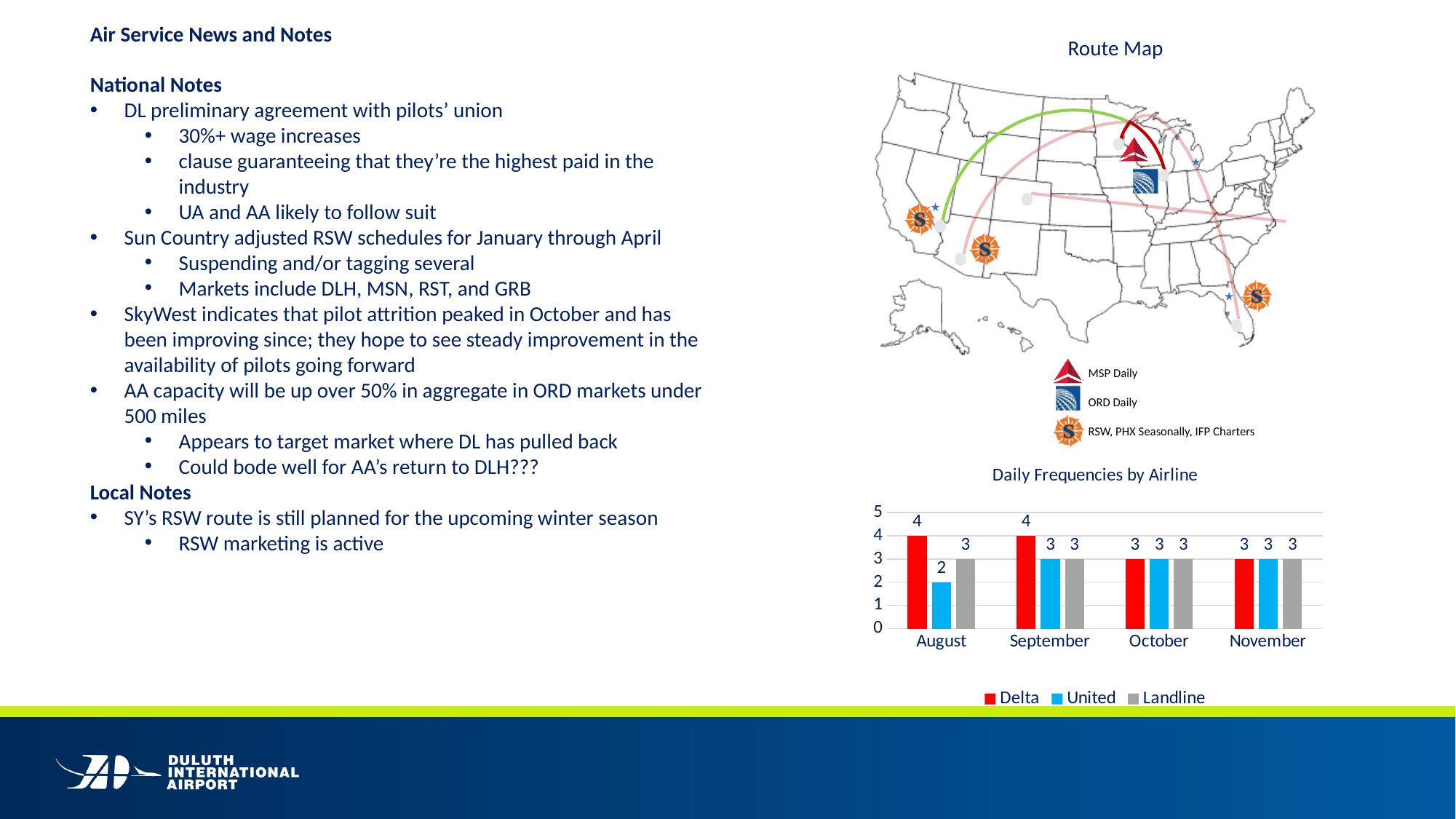
How many months are shown on the x axis of the 'Daily Frequencies by Airline' chart? 4 In the 'Daily Frequencies by Airline' chart, which is larger in September: Delta or United? Delta In the 'Daily Frequencies by Airline' chart, what is the difference between Delta and United in August? 2 What is the value for Landline in September in the 'Daily Frequencies by Airline' chart? 3 Which series is shown in red in the 'Daily Frequencies by Airline' chart? Delta In the 'Daily Frequencies by Airline' chart, which month has the lowest value for United? August What is the value for Delta in August in the 'Daily Frequencies by Airline' chart? 4 What type of chart is 'Daily Frequencies by Airline'? bar chart What is the value for United in August in the 'Daily Frequencies by Airline' chart? 2 In the 'Daily Frequencies by Airline' chart, does the value for Delta rise or fall from September to October? fall What is the title of the bar chart on the slide? Daily Frequencies by Airline How many series does the legend of the 'Daily Frequencies by Airline' chart list? 3